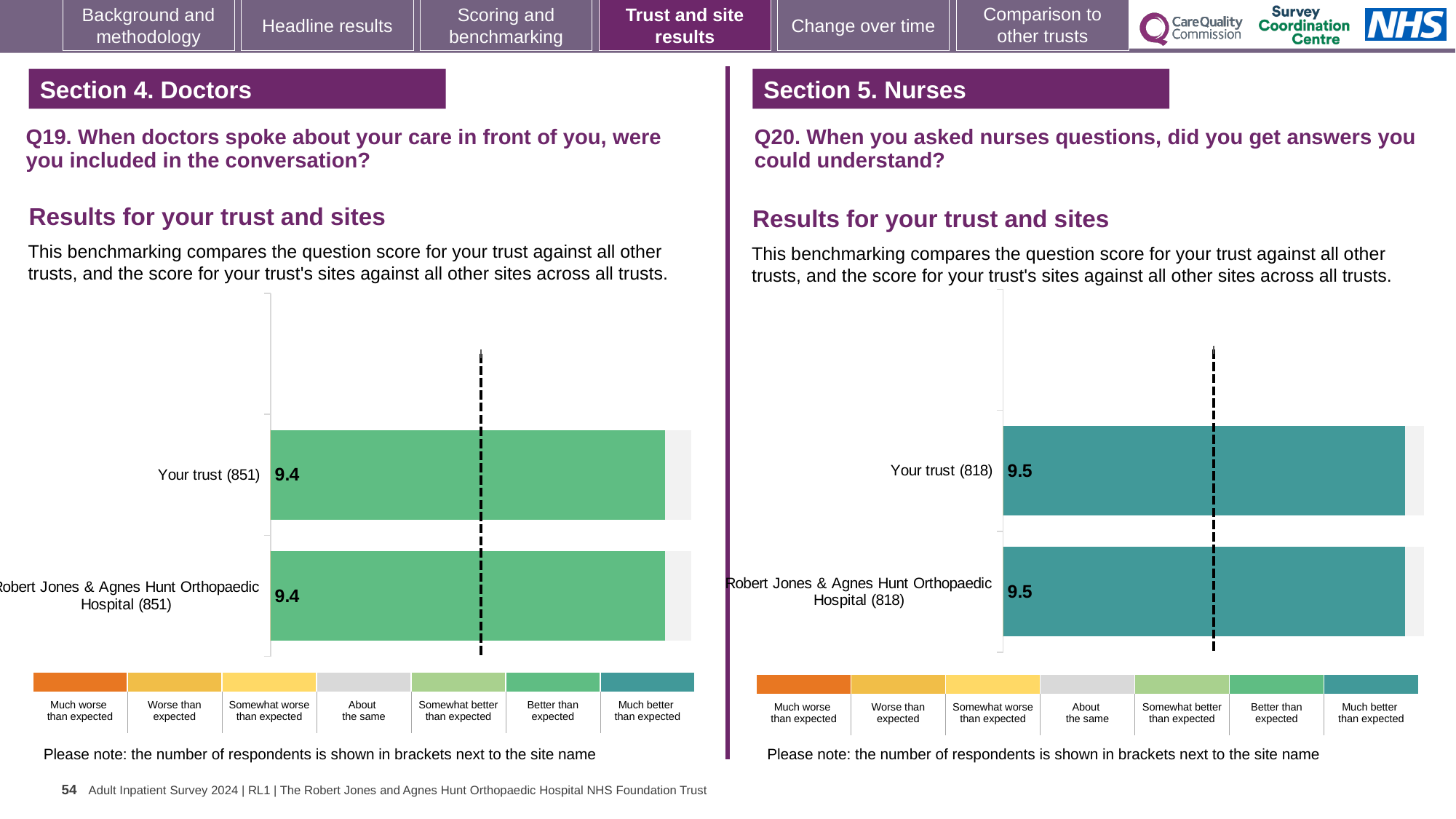
In the Q19 chart on the left, what is the difference between the score for Your trust and the score for Robert Jones & Agnes Hunt Orthopaedic Hospital? 0 In the Q19 chart on the left, which category of the colour key does the colour of the bars correspond to? Better than expected How many categories does the colour key below the Q20 chart on the right list? 7 In the Q20 chart on the right, what is the score for Your trust? 9.5 In the Q20 chart on the right, what is the score for Robert Jones & Agnes Hunt Orthopaedic Hospital? 9.5 In the Q20 chart on the right, how many respondents are shown in brackets next to Robert Jones & Agnes Hunt Orthopaedic Hospital? 818 Is the score for Your trust in the Q20 chart on the right larger than, smaller than, or equal to the score for Robert Jones & Agnes Hunt Orthopaedic Hospital in the same chart? Equal In the Q19 chart on the left, what is the score for Robert Jones & Agnes Hunt Orthopaedic Hospital? 9.4 In the Q19 chart on the left, what is the score for Your trust? 9.4 What kind of chart is the Q19 chart on the left? Bar chart In the Q20 chart on the right, how many bars are plotted? 2 In the Q19 chart on the left, how many respondents are shown in brackets next to Your trust? 851